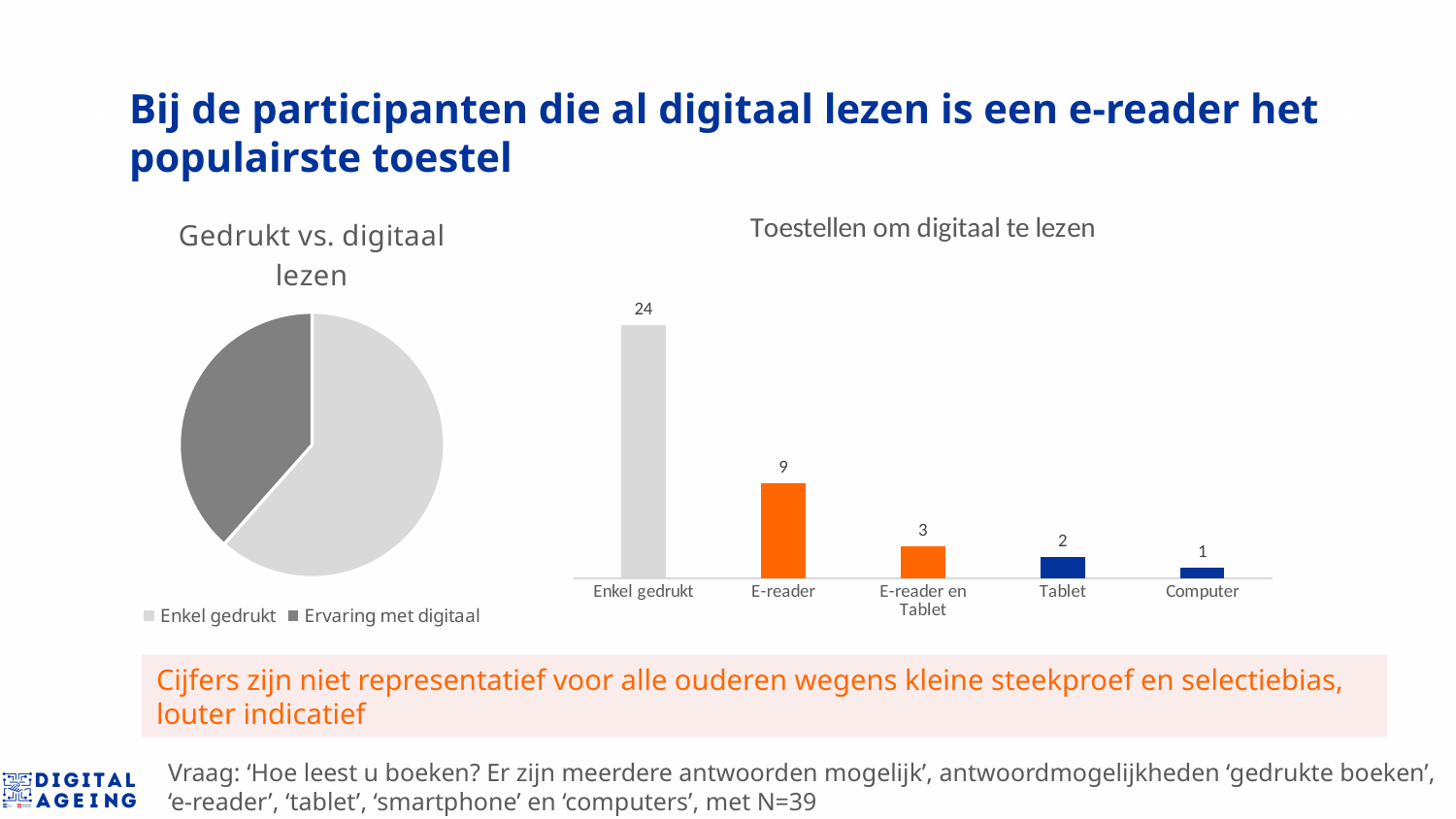
How many categories are shown in the chart titled 'Toestellen om digitaal te lezen'? 5 What kind of chart is 'Toestellen om digitaal te lezen'? Bar chart In the chart titled 'Toestellen om digitaal te lezen', what is the value for Enkel gedrukt? 24 In the pie chart 'Gedrukt vs. digitaal lezen', which slice is larger: Enkel gedrukt or Ervaring met digitaal? Enkel gedrukt In the chart titled 'Toestellen om digitaal te lezen', which category has the highest value? Enkel gedrukt In the chart titled 'Toestellen om digitaal te lezen', what is the value for E-reader? 9 In the chart titled 'Toestellen om digitaal te lezen', which category has the lowest value? Computer What kind of chart is 'Gedrukt vs. digitaal lezen'? Pie chart In the chart titled 'Toestellen om digitaal te lezen', which is larger: the value for E-reader or the value for Tablet? E-reader In the chart titled 'Toestellen om digitaal te lezen', what is the difference between the values for E-reader and E-reader en Tablet? 6 In the chart titled 'Toestellen om digitaal te lezen', do the values rise or fall from left to right along the x axis? Fall In the chart titled 'Toestellen om digitaal te lezen', what is the value for Tablet? 2